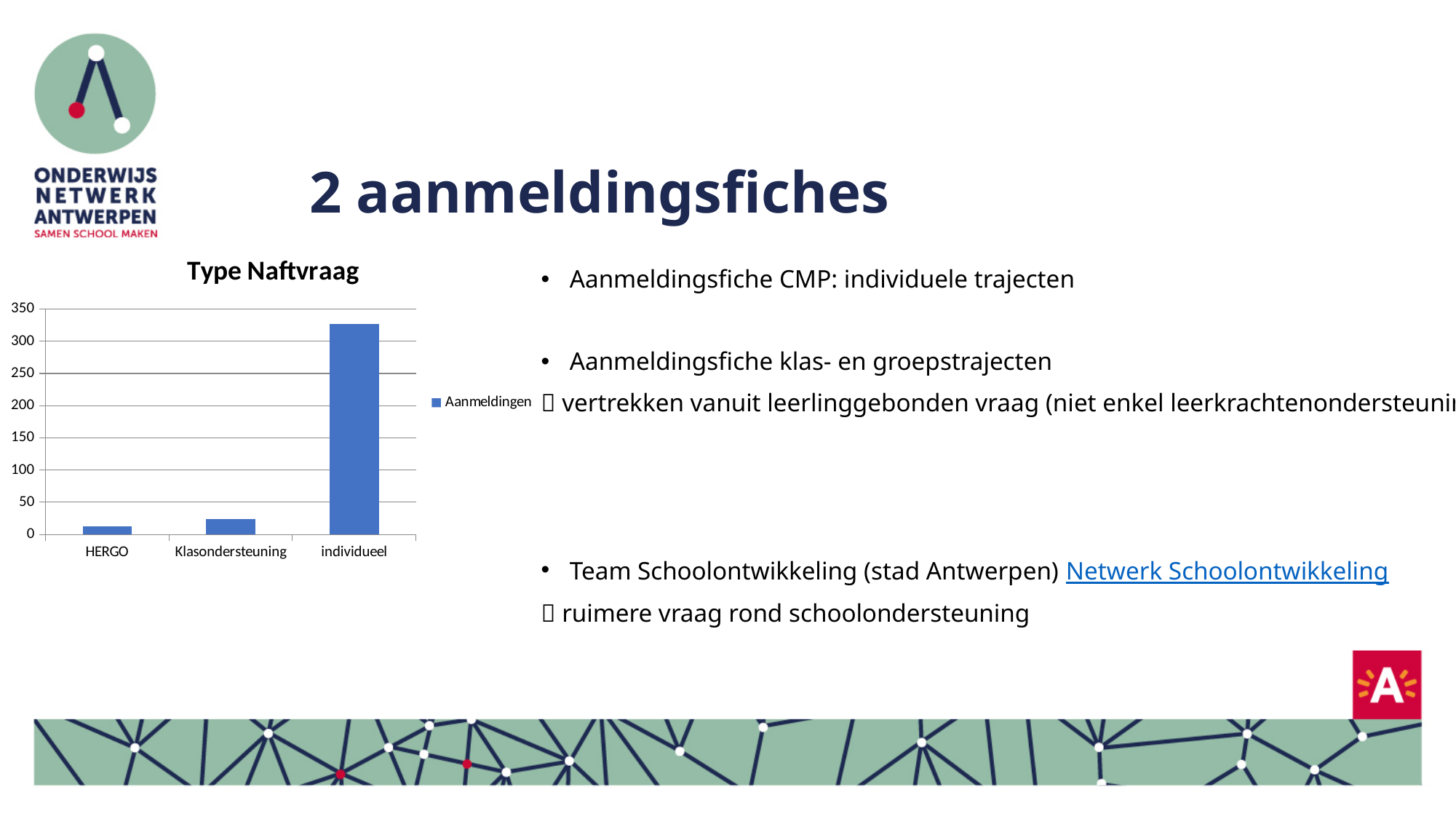
What is the highest value shown on the y axis of the 'Type Naftvraag' chart? 350 How many categories are shown on the x axis of the 'Type Naftvraag' chart? 3 How many series does the legend of the 'Type Naftvraag' chart list? 1 What kind of chart is shown under the title 'Type Naftvraag'? bar chart In the 'Type Naftvraag' chart, is the value for HERGO greater or less than 50? less What is the title of the chart on the slide? Type Naftvraag Which category has the highest value in the 'Type Naftvraag' chart? individueel What is the name of the series shown in the legend of the 'Type Naftvraag' chart? Aanmeldingen Which category has the lowest value in the 'Type Naftvraag' chart? HERGO In the 'Type Naftvraag' chart, is the value for Klasondersteuning greater or less than 50? less In the 'Type Naftvraag' chart, is the value for individueel greater or less than 300? greater In the 'Type Naftvraag' chart, which is larger: the value for Klasondersteuning or the value for HERGO? Klasondersteuning